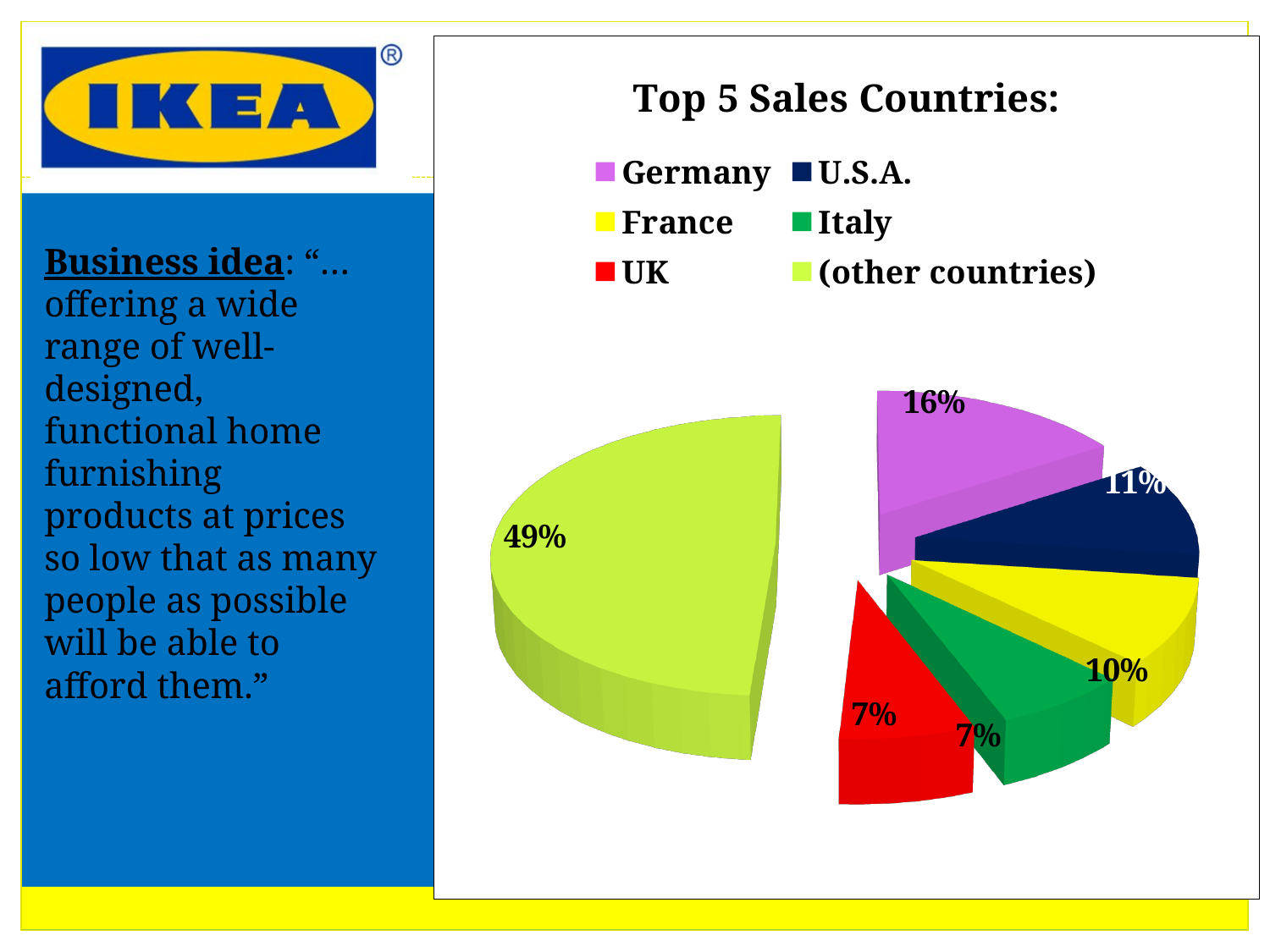
Which slice of the pie is the largest? (other countries) How many entries does the chart's legend list? 6 Which is larger, the share for the U.S.A. or the share for Italy? U.S.A. What share of sales does the U.S.A. account for? 11% What share of sales does Germany account for? 16% What colour represents the UK in the chart? red What share of sales does France account for? 10% What is the difference in percentage points between Germany's share and France's share? 6 What share of sales do the other countries account for? 49% Among the five named countries, which has the largest share? Germany What is the title of the chart? Top 5 Sales Countries: What kind of chart is shown on the slide? pie chart